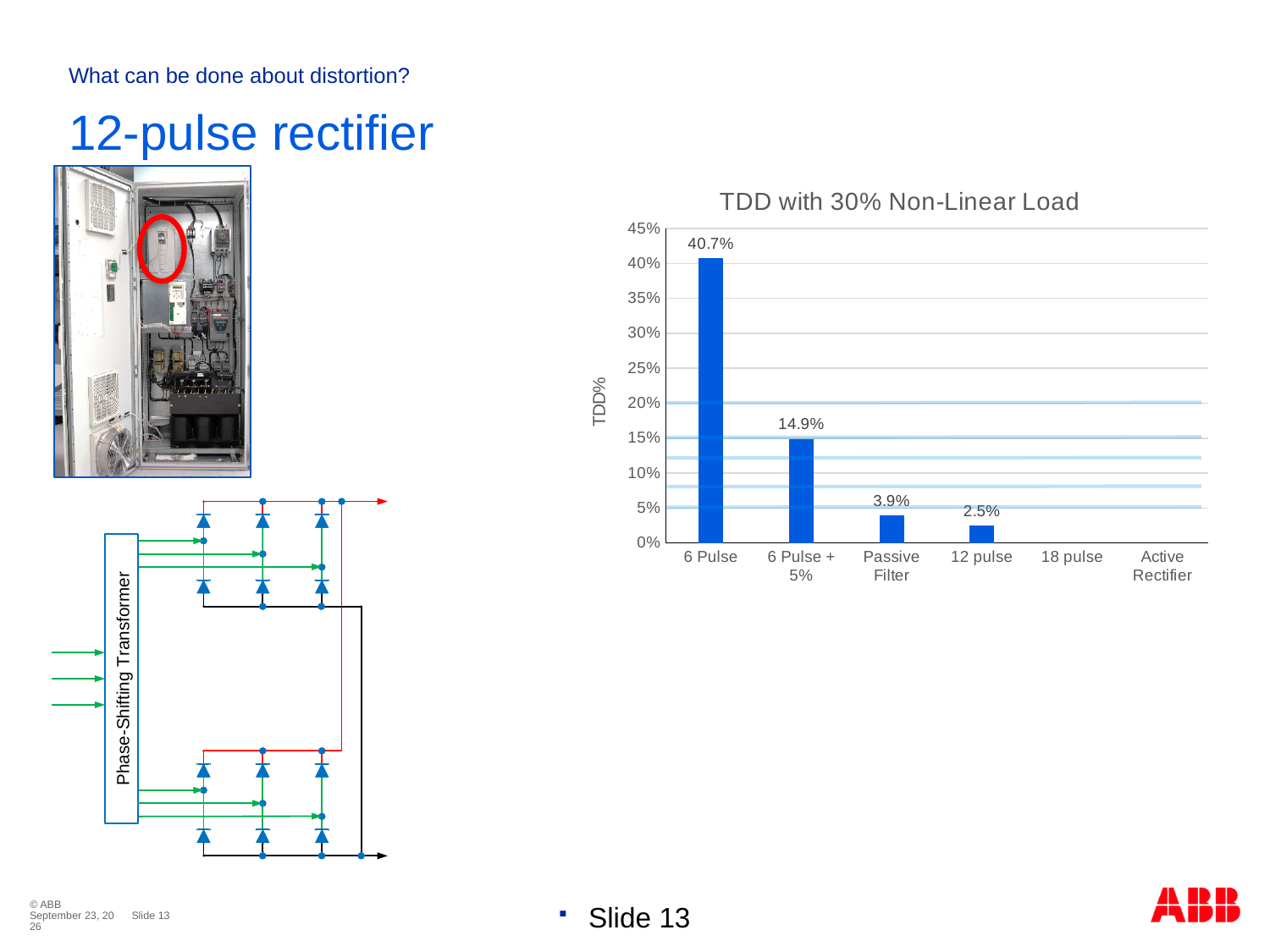
Which category has the tallest bar in the chart? 6 Pulse What is the TDD value for 6 Pulse + 5%? 14.9% What is the TDD value for Passive Filter? 3.9% Which has a higher TDD value, Passive Filter or 6 Pulse + 5%? 6 Pulse + 5% Which of the labelled bars has the lowest TDD value? 12 pulse What is the TDD value for 12 pulse? 2.5% What is the TDD value for 6 Pulse in the chart? 40.7% What kind of chart is shown on the slide? Bar chart What is the title of the chart? TDD with 30% Non-Linear Load What is the difference between the TDD values for Passive Filter and 12 pulse? 1.4% What is the difference between the TDD values for 6 Pulse and 6 Pulse + 5%? 25.8% How many categories are shown on the x axis of the chart? 6